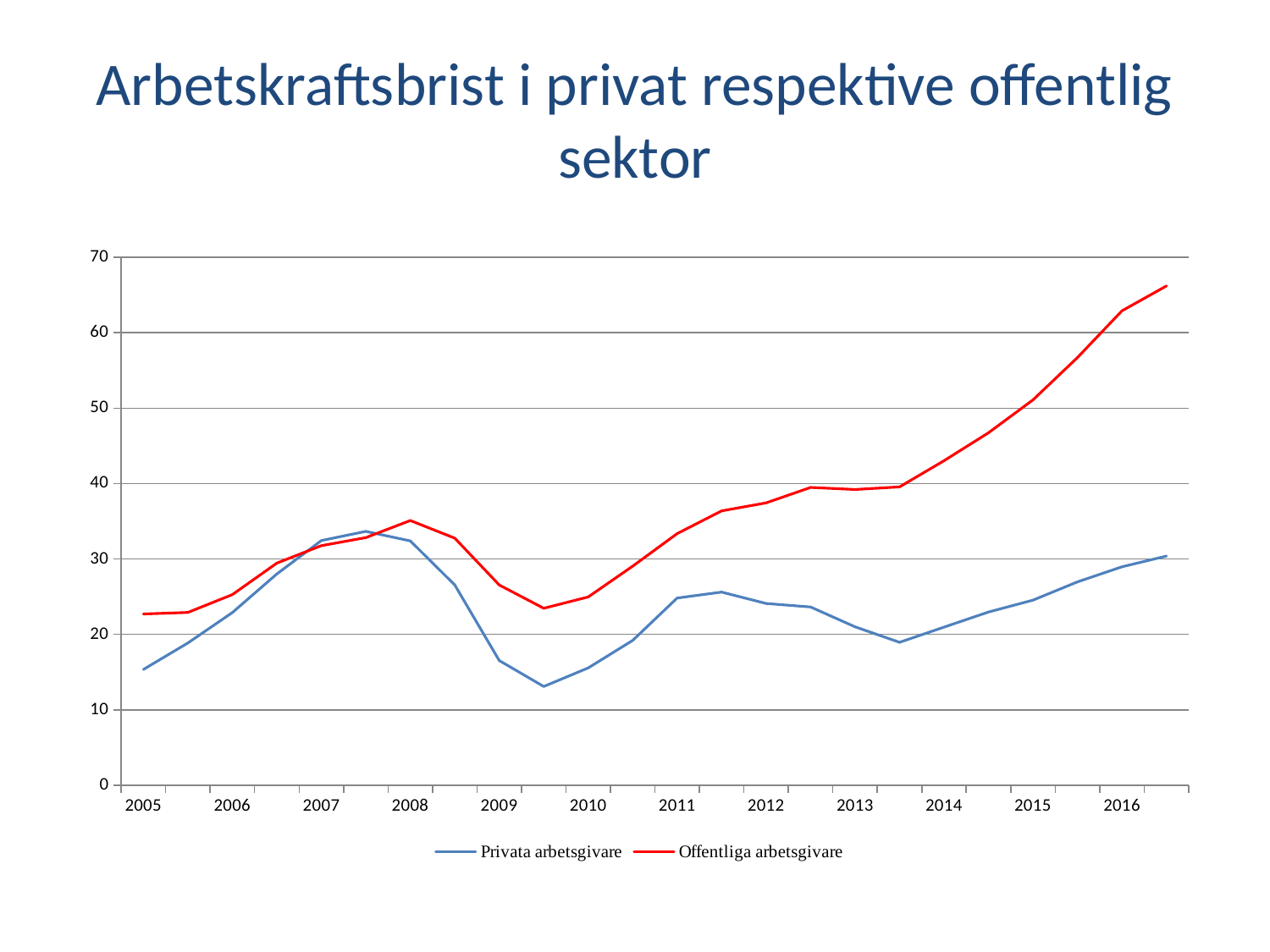
What are the two series named in the legend? Privata arbetsgivare and Offentliga arbetsgivare Does the Offentliga arbetsgivare line rise or fall from 2013 to 2016? rise In which year does the Offentliga arbetsgivare line reach its highest value? 2016 Which colour is used for the Offentliga arbetsgivare line? red What kind of chart is shown on the slide? line chart Is the value for Offentliga arbetsgivare in 2015 greater or less than 40? greater In 2016, which series has the higher value, Privata arbetsgivare or Offentliga arbetsgivare? Offentliga arbetsgivare How many years are labelled on the x axis? 12 How many series does the legend list? 2 Is the value for Privata arbetsgivare in 2009 greater or less than 20? less Is the value for Offentliga arbetsgivare at the end of 2016 greater or less than 60? greater